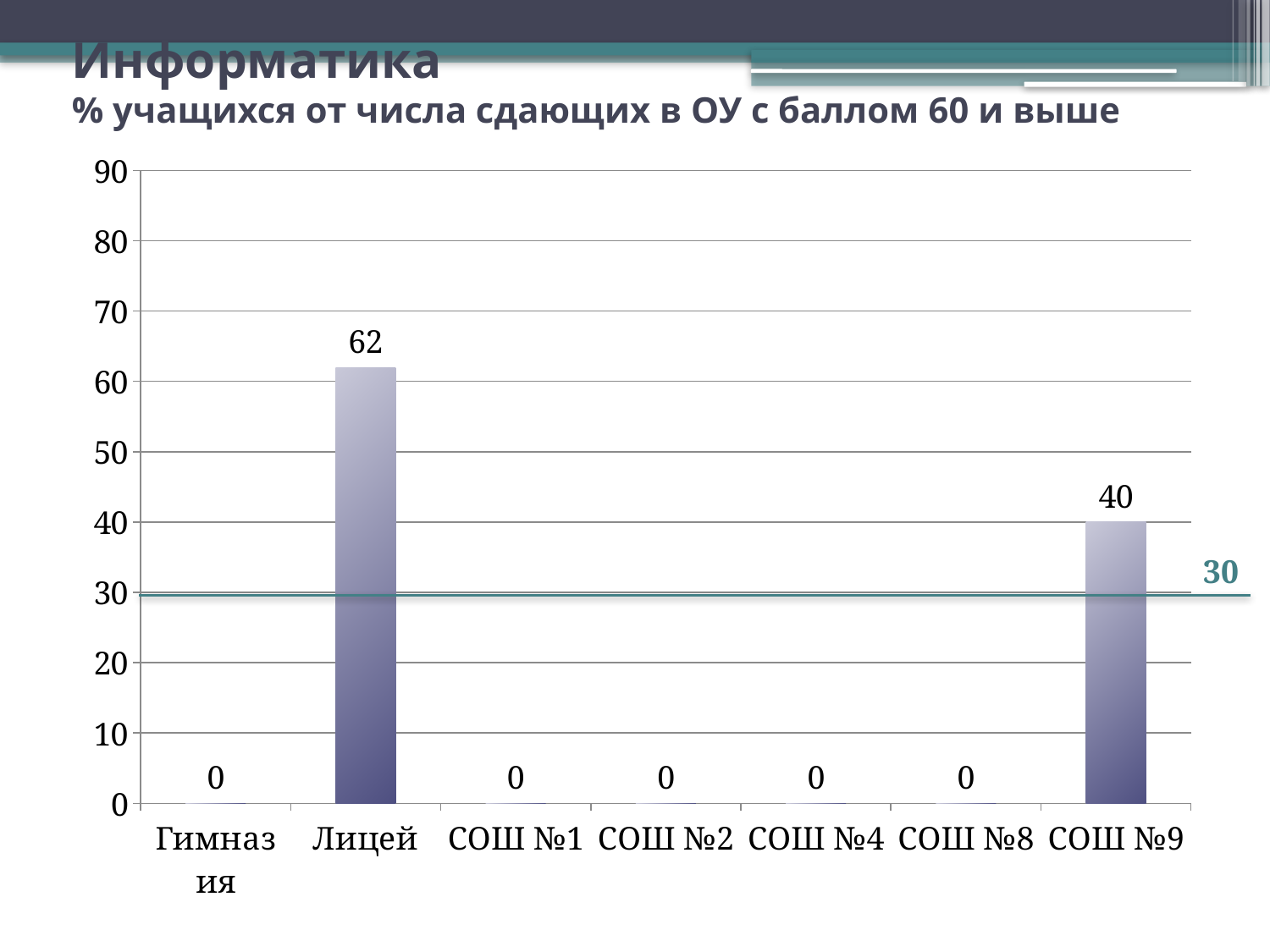
How many categories are shown on the x axis? 7 What value is marked by the horizontal line across the chart? 30 Which is larger, the value for Лицей or the value for СОШ №9? Лицей What is the value for Лицей? 62 Which category has the highest value? Лицей What kind of chart is shown on the slide? bar chart How many categories have a value of 0? 5 What is the value for Гимназия? 0 Is the value for СОШ №9 greater or less than 30? greater What is the difference between the values for Лицей and СОШ №9? 22 What is the value for СОШ №9? 40 What is the value for СОШ №4? 0